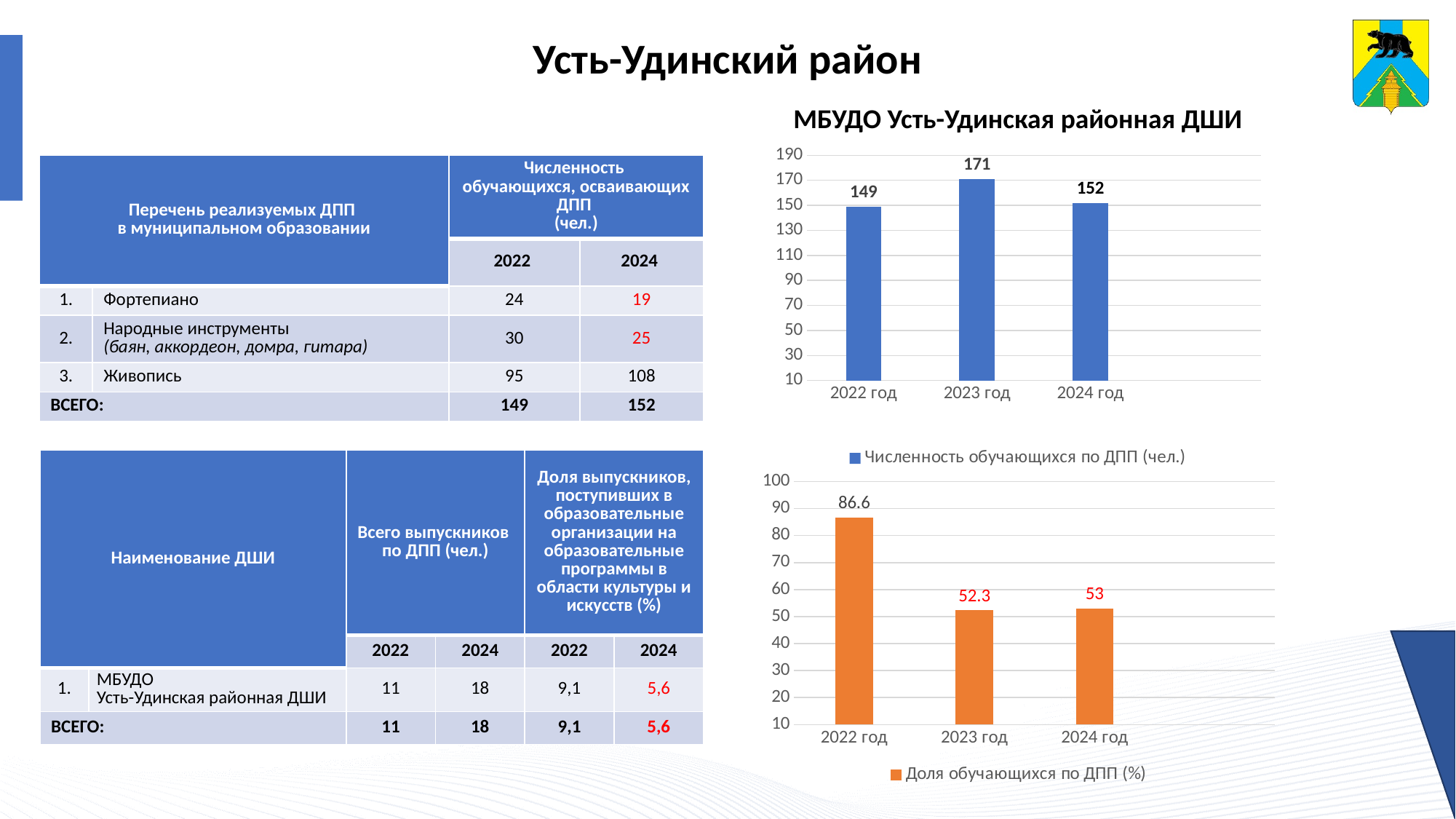
In the bottom chart with the orange bars, what is the value for 2022 год? 86.6 What is the legend entry of the bottom chart with the orange bars? Доля обучающихся по ДПП (%) In the top chart titled 'МБУДО Усть-Удинская районная ДШИ', what is the difference between the values for 2023 год and 2024 год? 19 In the bottom chart with the orange bars, which year has the highest value? 2022 год In the top chart titled 'МБУДО Усть-Удинская районная ДШИ', which year has the highest value? 2023 год In the top chart titled 'МБУДО Усть-Удинская районная ДШИ', how many bars are plotted? 3 In the top chart titled 'МБУДО Усть-Удинская районная ДШИ', which year has the lowest value? 2022 год What type of chart is the bottom chart with the orange bars? bar chart In the top chart titled 'МБУДО Усть-Удинская районная ДШИ', what is the value for 2022 год? 149 In the bottom chart with the orange bars, is the value for 2024 год greater or less than 60? less In the top chart titled 'МБУДО Усть-Удинская районная ДШИ', what is the value for 2023 год? 171 In the bottom chart with the orange bars, what is the value for 2023 год? 52.3